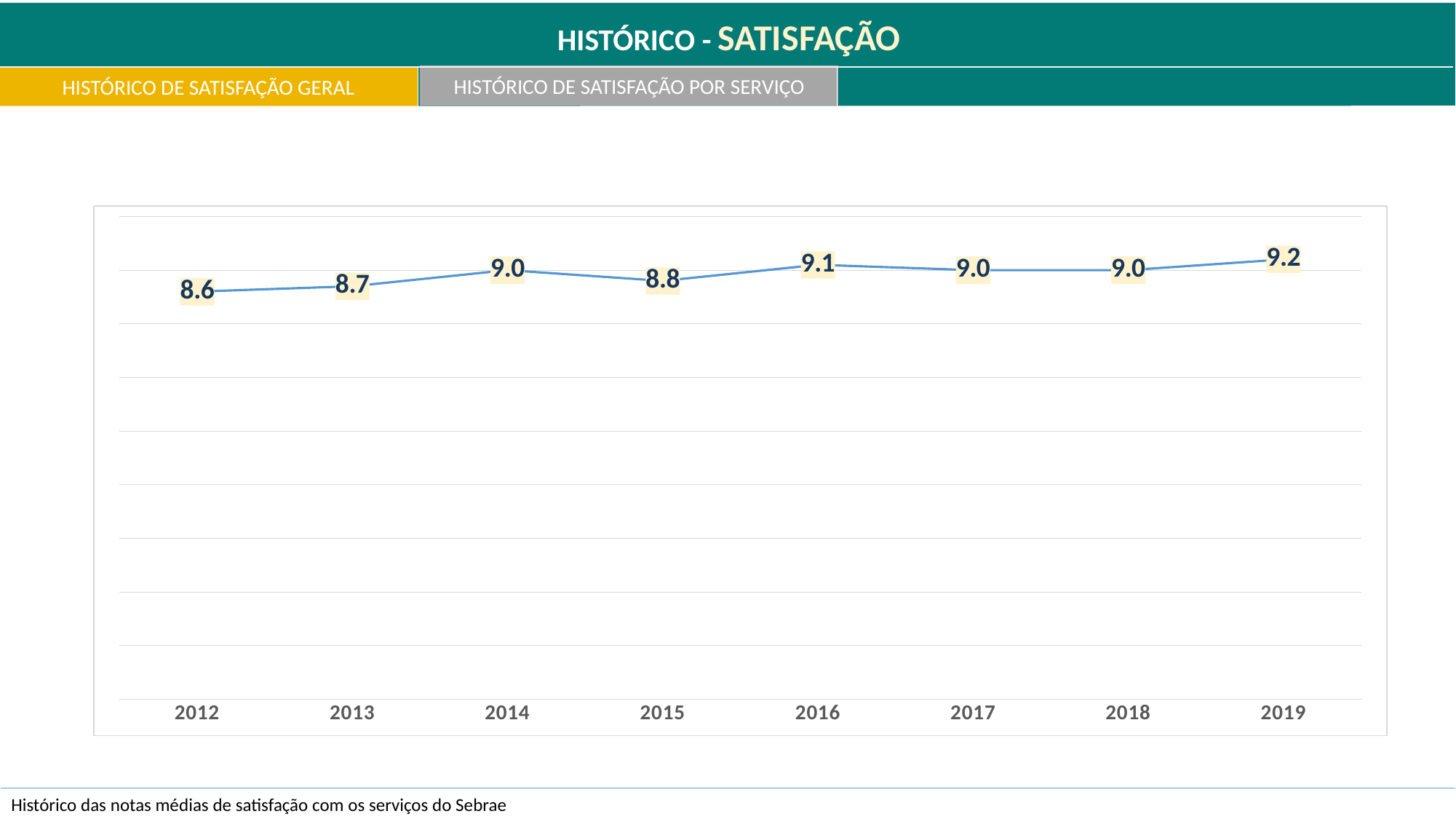
Which year has a higher satisfaction score, 2014 or 2015? 2014 Which tab is highlighted in yellow above the chart? HISTÓRICO DE SATISFAÇÃO GERAL What is the satisfaction score for 2019? 9.2 What is the satisfaction score for 2015? 8.8 What kind of chart is shown on the slide? Line chart What is the satisfaction score for 2012? 8.6 How many years are shown on the x axis? 8 Which year has the highest satisfaction score? 2019 Do the satisfaction scores generally rise or fall from 2012 to 2019? Rise What is the difference between the satisfaction scores for 2019 and 2012? 0.6 What is the satisfaction score for 2016? 9.1 Which year has the lowest satisfaction score? 2012